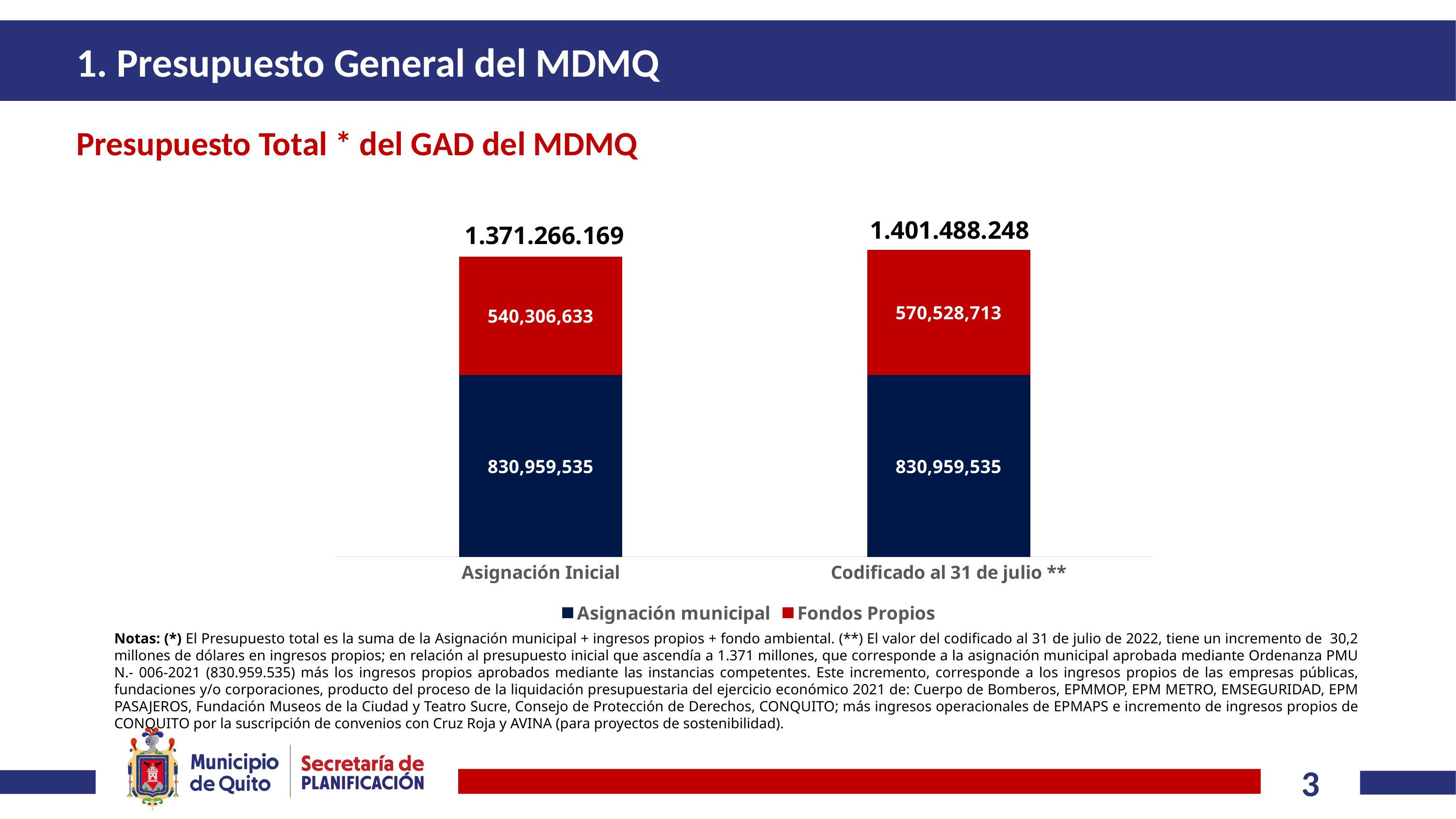
How many series does the legend list? 2 What is the difference in Fondos Propios between Codificado al 31 de julio ** and Asignación Inicial? 30,222,080 What is the value of Asignación municipal for Asignación Inicial? 830,959,535 What is the value of Asignación municipal for Codificado al 31 de julio **? 830,959,535 What is the total of the stacked bar for Codificado al 31 de julio **? 1.401.488.248 Which category has the higher Fondos Propios value? Codificado al 31 de julio ** What kind of chart is shown on the slide? Stacked bar chart What is the value of Fondos Propios for Asignación Inicial? 540,306,633 What is the total of the stacked bar for Asignación Inicial? 1.371.266.169 What is the value of Fondos Propios for Codificado al 31 de julio **? 570,528,713 Which series is shown in red in the chart? Fondos Propios How many categories are shown on the x axis? 2